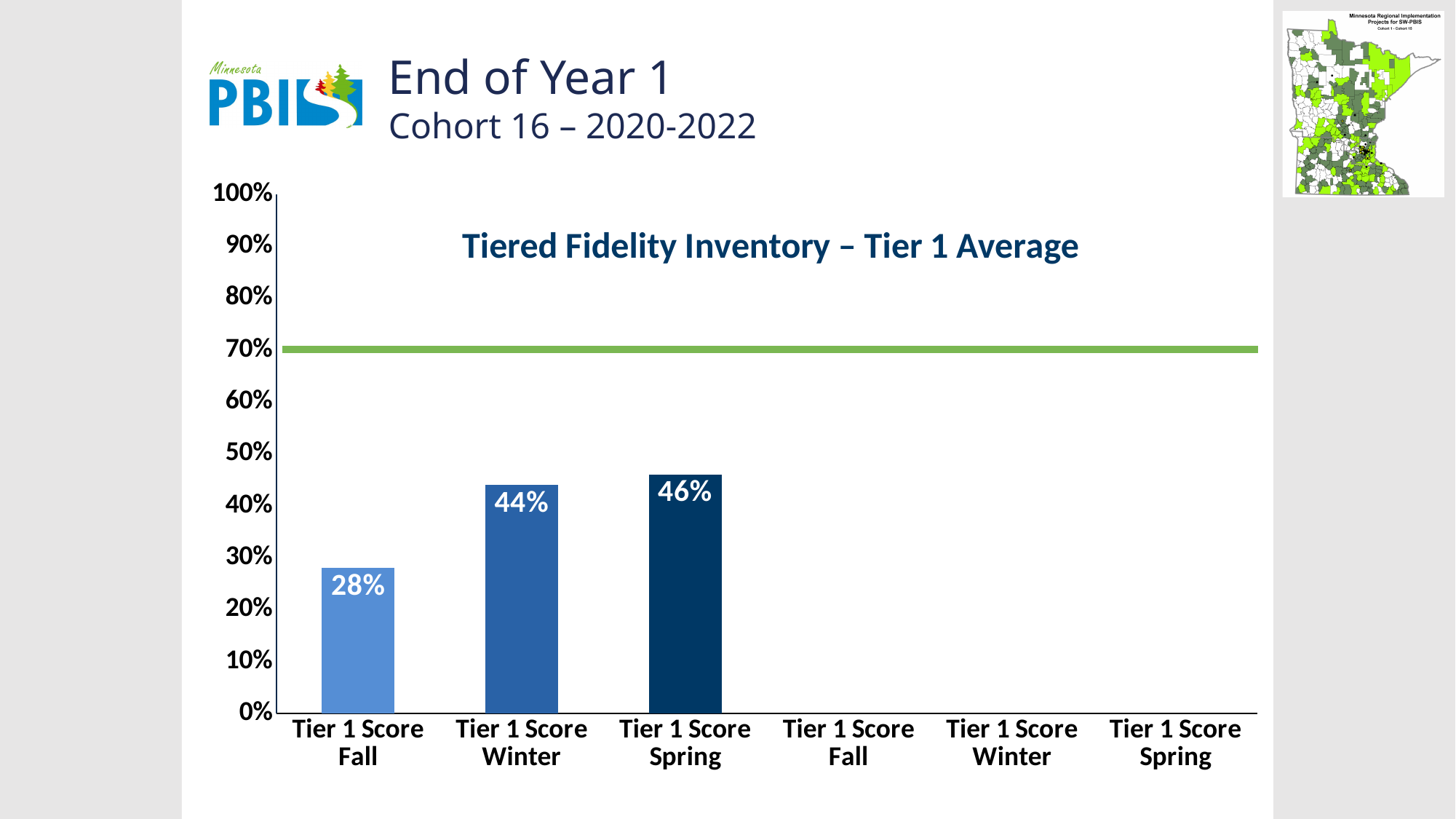
Do the bar values rise or fall from Fall to Spring? Rise What is the value of the Tier 1 Score Winter bar? 44% Which bar has the lowest value? Tier 1 Score Fall Is the value for Tier 1 Score Fall greater or less than 30%? less How many bars are plotted on the chart? 3 Which bar has the highest value? Tier 1 Score Spring Which is larger, the Tier 1 Score Fall value or the Tier 1 Score Winter value? Tier 1 Score Winter What kind of chart is shown on the slide? Bar chart What is the value of the Tier 1 Score Fall bar? 28% What is the difference between the Tier 1 Score Spring and Tier 1 Score Fall values? 18% What is the value of the Tier 1 Score Spring bar? 46% What is the difference between the Tier 1 Score Winter and Tier 1 Score Fall values? 16%